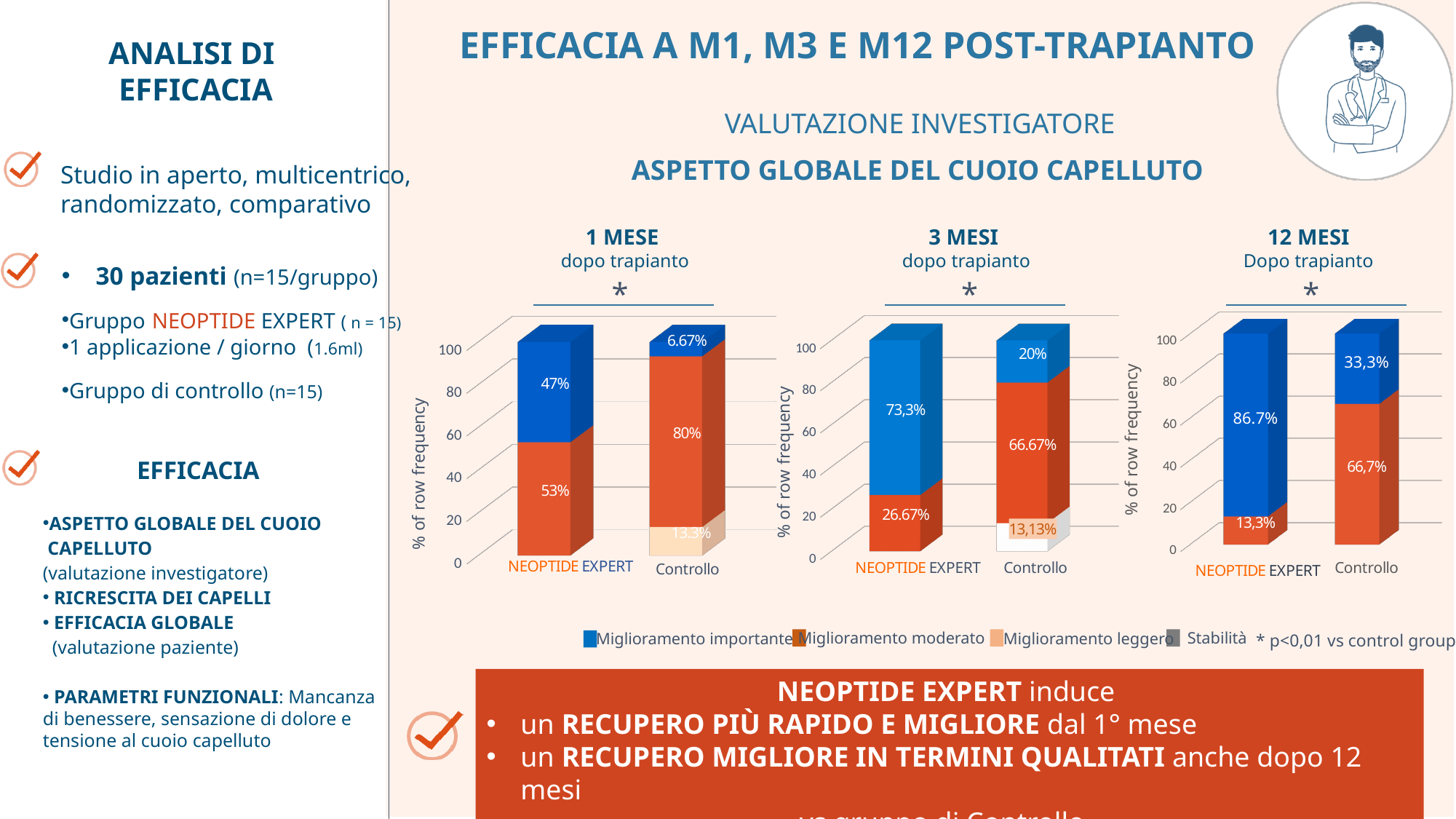
In the '1 MESE' chart, what is the value of 'Miglioramento leggero' for Controllo? 13.3% In the '1 MESE' chart, what is the difference between the 'Miglioramento moderato' values for Controllo and NEOPTIDE EXPERT? 27% In the '1 MESE' chart, what is the value of 'Miglioramento importante' for NEOPTIDE EXPERT? 47% In the '3 MESI' chart, what is the value of 'Miglioramento importante' for Controllo? 20% In the '12 MESI' chart, what is the value of 'Miglioramento moderato' for Controllo? 66,7% How many series does the legend list for the charts? 4 What kind of chart is the '3 MESI' chart? Stacked bar chart In the '3 MESI' chart, what is the value of 'Miglioramento importante' for NEOPTIDE EXPERT? 73,3% In the '12 MESI' chart, which group has the larger 'Miglioramento importante' value, NEOPTIDE EXPERT or Controllo? NEOPTIDE EXPERT In the '1 MESE' chart, what is the value of 'Miglioramento moderato' for Controllo? 80% How many categories are shown on the x axis of the '12 MESI' chart? 2 In the '12 MESI' chart, what is the value of 'Miglioramento importante' for NEOPTIDE EXPERT? 86.7%